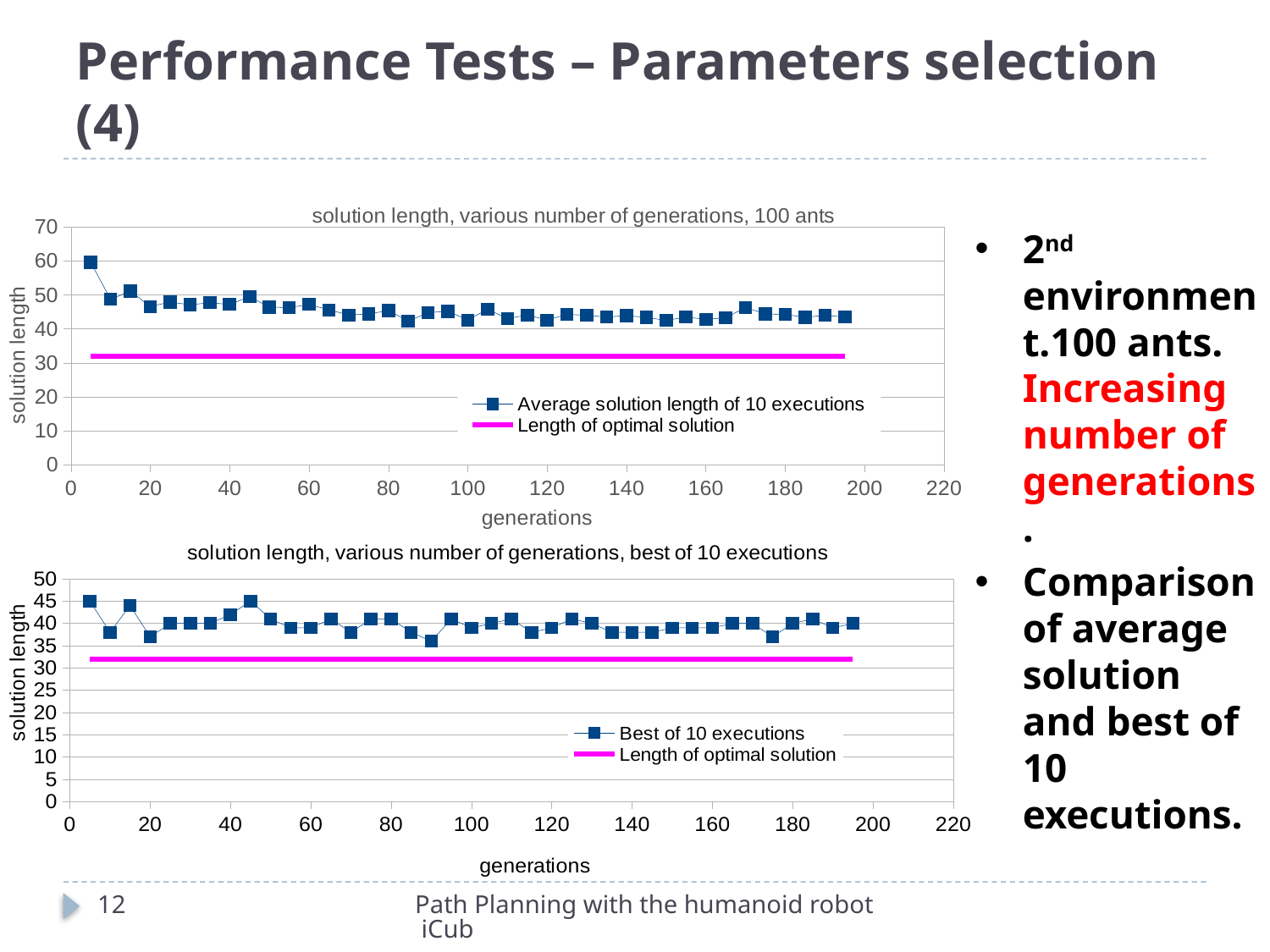
In the bottom chart ('best of 10 executions'), is the value at 45 generations greater or less than 40? greater In the bottom chart ('best of 10 executions'), is the value at 90 generations greater or less than 40? less In the bottom chart ('best of 10 executions'), which is larger: the value at 45 generations or at 90 generations? 45 generations What is the label of the y axis on the bottom chart? solution length What kind of chart is the top chart titled 'solution length, various number of generations, 100 ants'? line chart In the top chart ('100 ants'), at which number of generations is the average solution length highest? 5 In the top chart ('100 ants'), which is larger: the average solution length at 5 generations or at 195 generations? 5 generations How many series does the legend of the bottom chart ('best of 10 executions') list? 2 In the top chart ('100 ants'), is the average solution length at 5 generations greater or less than 50? greater In the top chart ('100 ants'), does the average solution length generally rise or fall as the number of generations increases? fall What does the magenta line represent in the top chart ('100 ants')? Length of optimal solution